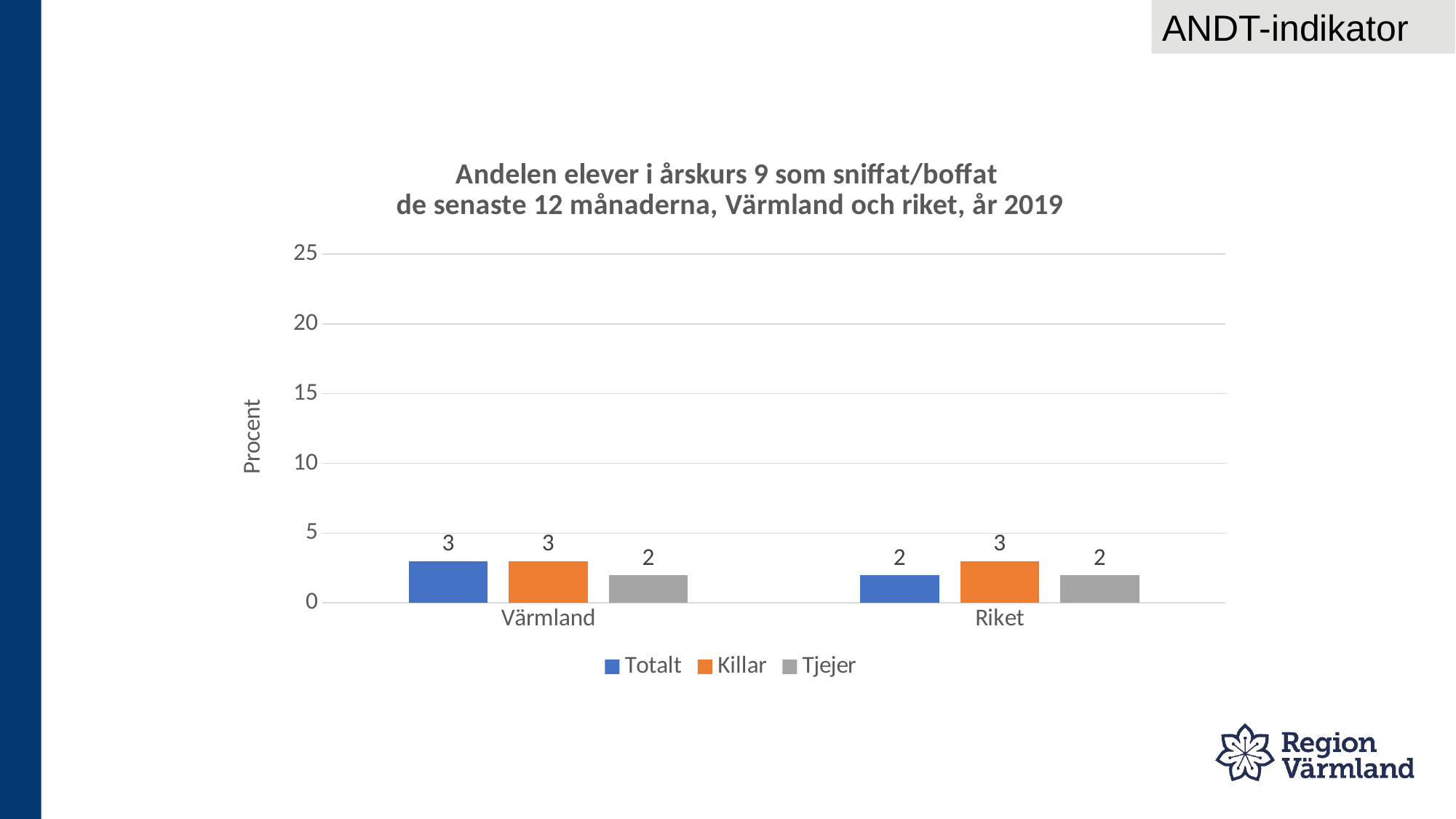
What is the value for Totalt in Riket? 2 Is the value for Killar in Värmland greater or less than 5? less What kind of chart is shown? bar chart What is the label of the y axis? Procent How many categories are shown on the x axis? 2 What is the difference between Totalt in Värmland and Totalt in Riket? 1 Which colour represents Killar in the legend? orange What is the value for Tjejer in Värmland? 2 What is the value for Totalt in Värmland? 3 How many series does the legend list? 3 What is the value for Killar in Riket? 3 Which is larger in Riket, Killar or Tjejer? Killar